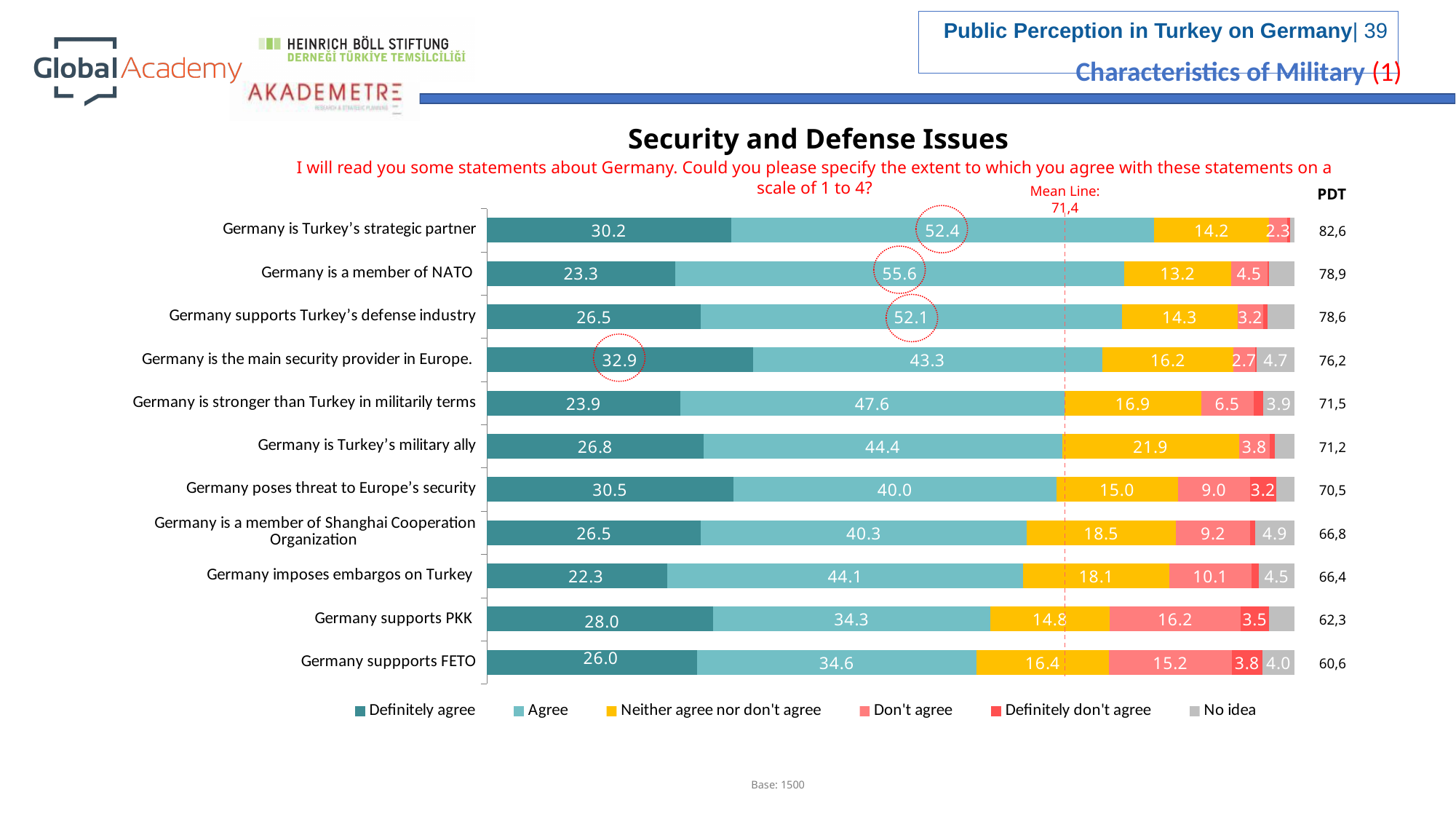
What is the 'Agree' value for 'Germany is a member of NATO'? 55.6 What kind of chart is shown on the slide? Bar chart What value is shown for the mean line in the chart? 71,4 How many statements are plotted in the chart? 11 What is the 'Neither agree nor don't agree' value for 'Germany is stronger than Turkey in militarily terms'? 16.9 Which statement has the highest 'Neither agree nor don't agree' value? Germany is Turkey's military ally Which statement has the highest 'Agree' value? Germany is a member of NATO How many series does the legend list? 6 Which statement has the lowest 'Definitely agree' value? Germany imposes embargos on Turkey What is the 'Definitely agree' value for 'Germany is the main security provider in Europe.'? 32.9 Which has the larger 'Don't agree' value: 'Germany supports PKK' or 'Germany suppports FETO'? Germany supports PKK What is the difference between the 'Neither agree nor don't agree' values for 'Germany is Turkey's military ally' and 'Germany poses threat to Europe's security'? 6.9